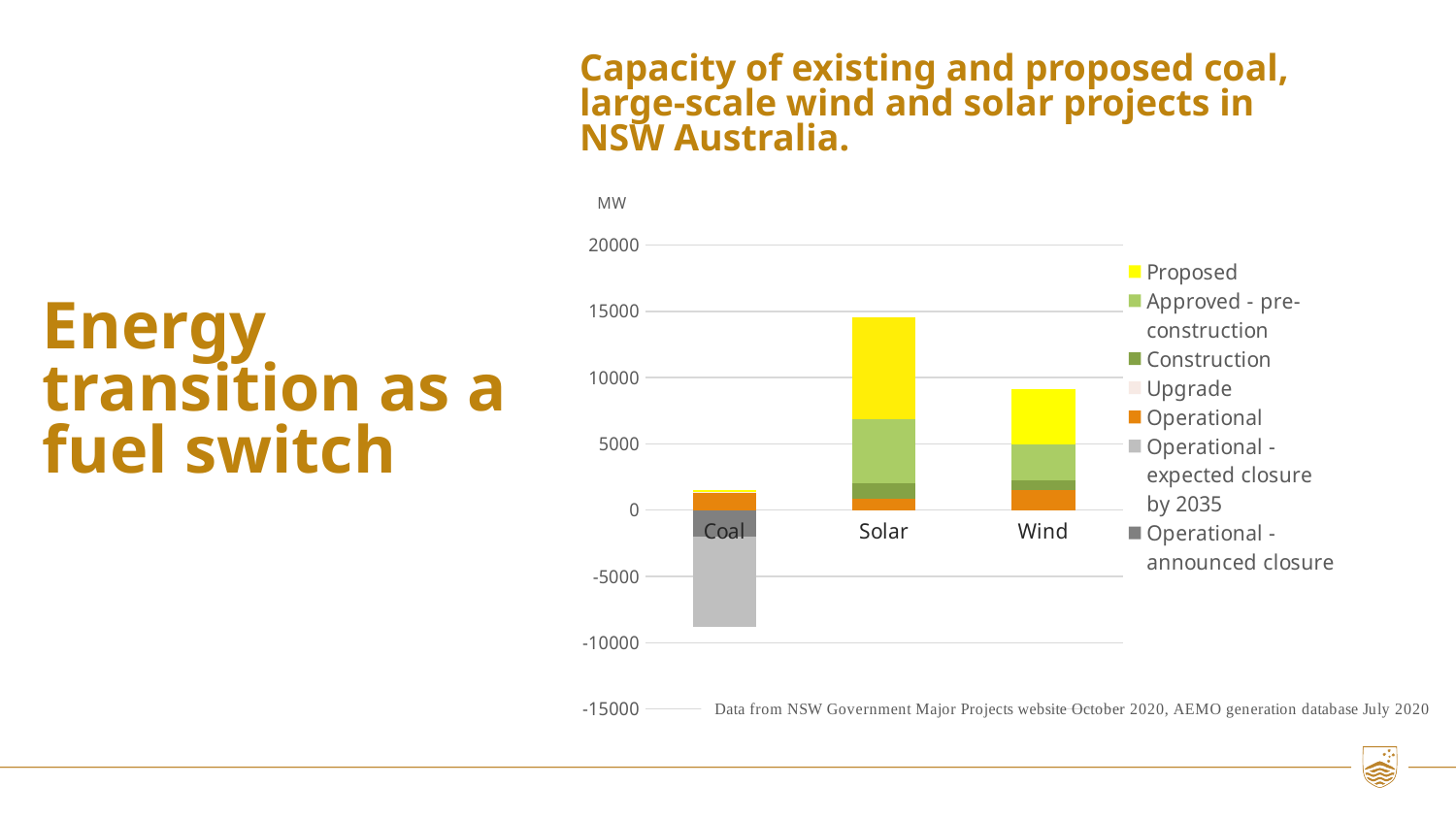
Which has a larger positive stacked total, Solar or Wind? Solar Which category has the smallest positive stacked bar? Coal How many series does the chart's legend list? 7 What kind of chart is shown on the slide? stacked bar chart Is the lowest point of the Coal bar greater or less than -5000 MW? less Which legend entry is shown in bright yellow? Proposed How many categories are shown on the x axis of the chart? 3 Is the top of the Solar stacked bar greater or less than 10000 MW? greater What unit is shown on the y axis of the chart? MW Which category has the tallest positive stacked bar? Solar Which category is the only one with a bar extending below zero? Coal Is the top of the Wind stacked bar greater or less than 10000 MW? less